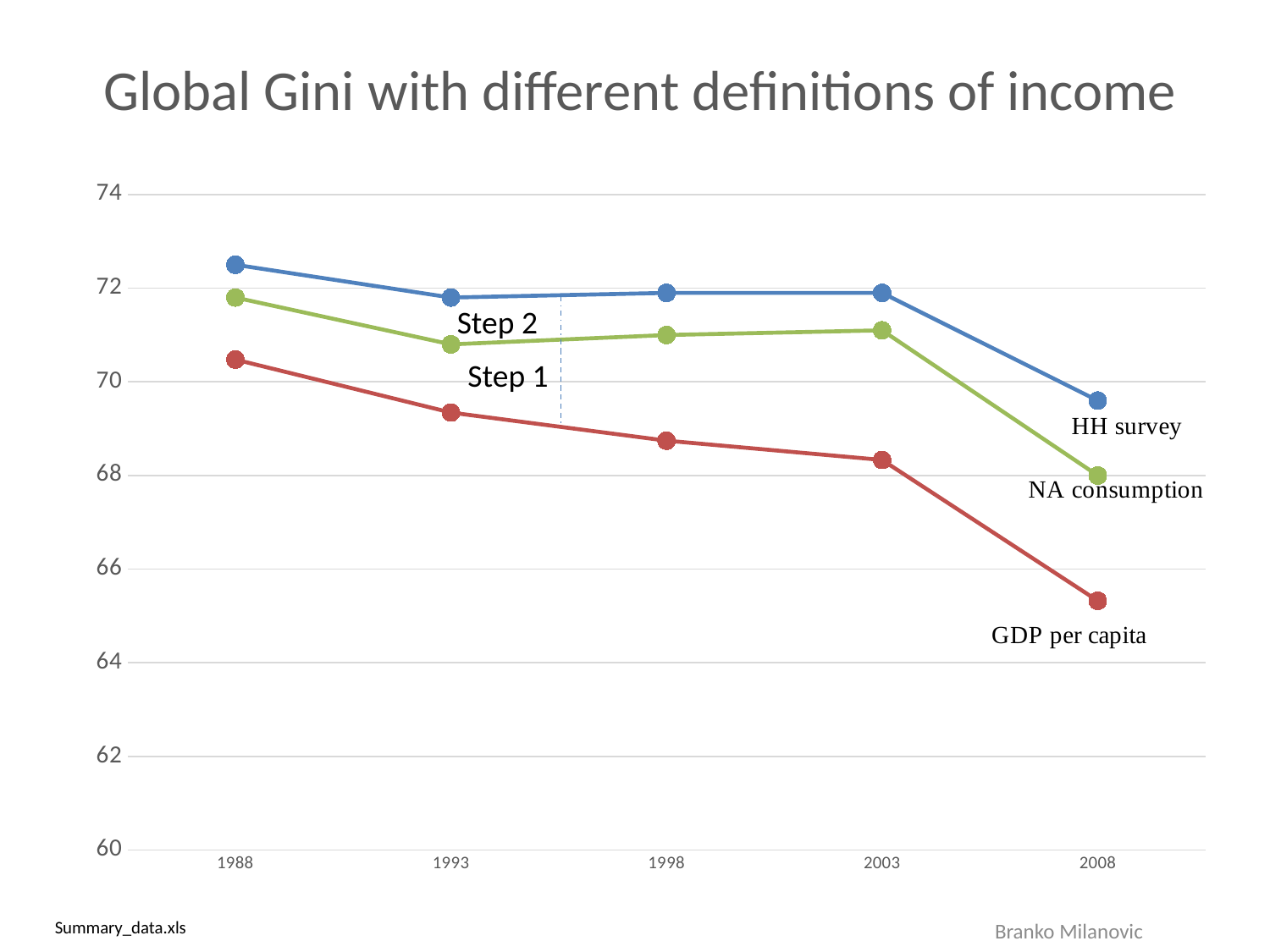
Is the GDP per capita value for 2008 greater or less than 66? less Does the GDP per capita line rise or fall from 1988 to 2008? fall What is the title of the chart? Global Gini with different definitions of income What kind of chart is shown on the slide? line chart How many series (lines) are plotted on the chart? 3 Which series has the highest value in 1988? HH survey What are the two step annotations written near the dashed vertical line? Step 1 and Step 2 Is the NA consumption value for 1993 greater or less than 70? greater How many years are plotted along the x axis? 5 Which series has the lowest value in 2003? GDP per capita Is the HH survey value for 1988 greater or less than 72? greater In 2008, which is larger: the HH survey value or the GDP per capita value? HH survey